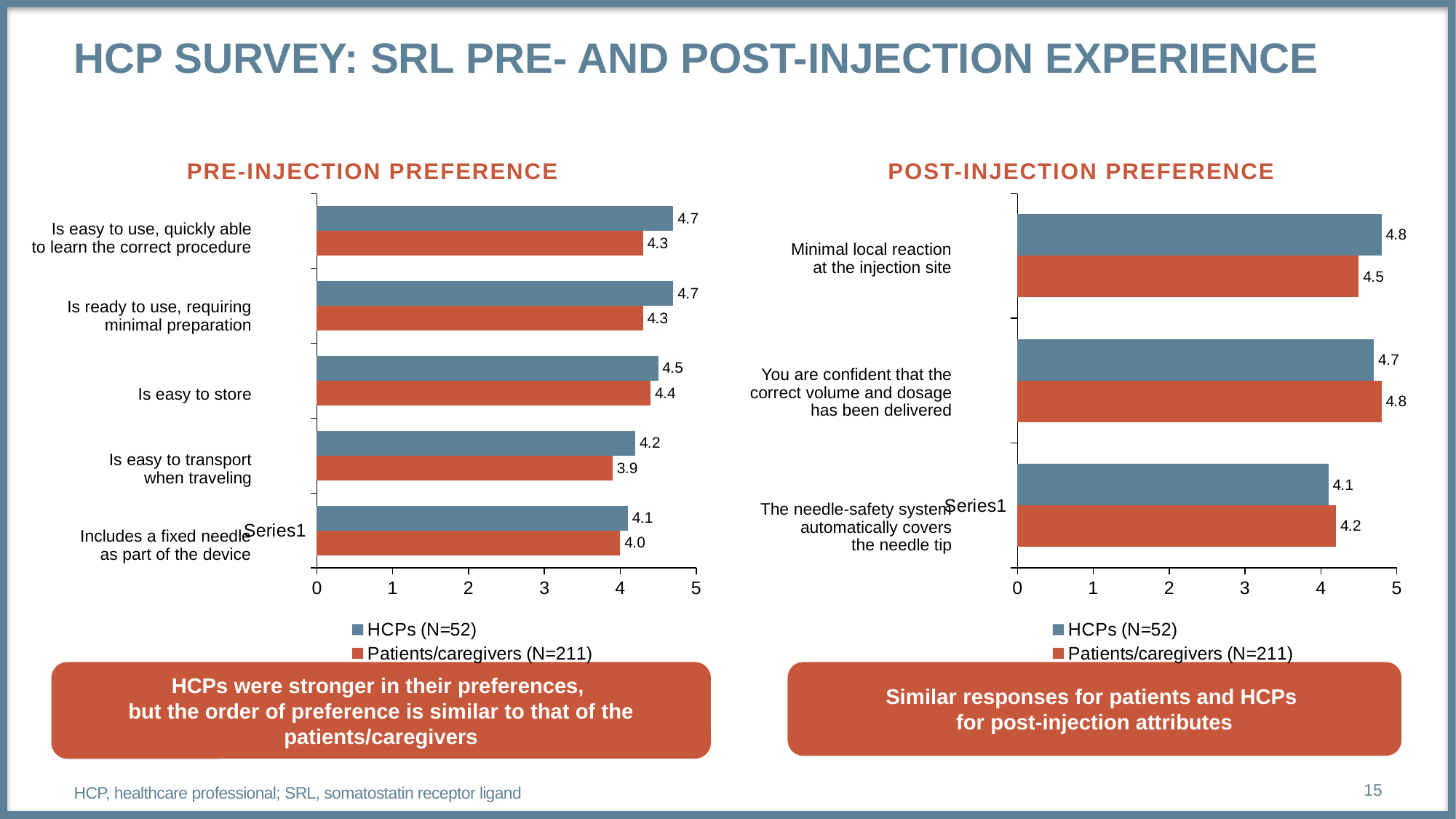
In the Post-Injection Preference chart, what is the Patients/caregivers (N=211) value for 'Minimal local reaction at the injection site'? 4.5 In the Pre-Injection Preference chart, which colour represents the HCPs (N=52) series? Blue-grey In the Pre-Injection Preference chart, what is the HCPs (N=52) value for 'Is easy to store'? 4.5 In the Post-Injection Preference chart, which is larger for 'You are confident that the correct volume and dosage has been delivered': the HCPs (N=52) value or the Patients/caregivers (N=211) value? Patients/caregivers (N=211) In the Pre-Injection Preference chart, what is the Patients/caregivers (N=211) value for 'Is easy to transport when traveling'? 3.9 In the Post-Injection Preference chart, what is the HCPs (N=52) value for 'The needle-safety system automatically covers the needle tip'? 4.1 In the Pre-Injection Preference chart, which category has the lowest Patients/caregivers (N=211) value? Is easy to transport when traveling What type of chart is the Post-Injection Preference chart? Bar chart In the Pre-Injection Preference chart, what is the difference between the HCPs (N=52) and Patients/caregivers (N=211) values for 'Is easy to use, quickly able to learn the correct procedure'? 0.4 How many categories are shown in the Pre-Injection Preference chart? 5 How many series does the legend of the Post-Injection Preference chart list? 2 In the Post-Injection Preference chart, which category has the highest HCPs (N=52) value? Minimal local reaction at the injection site